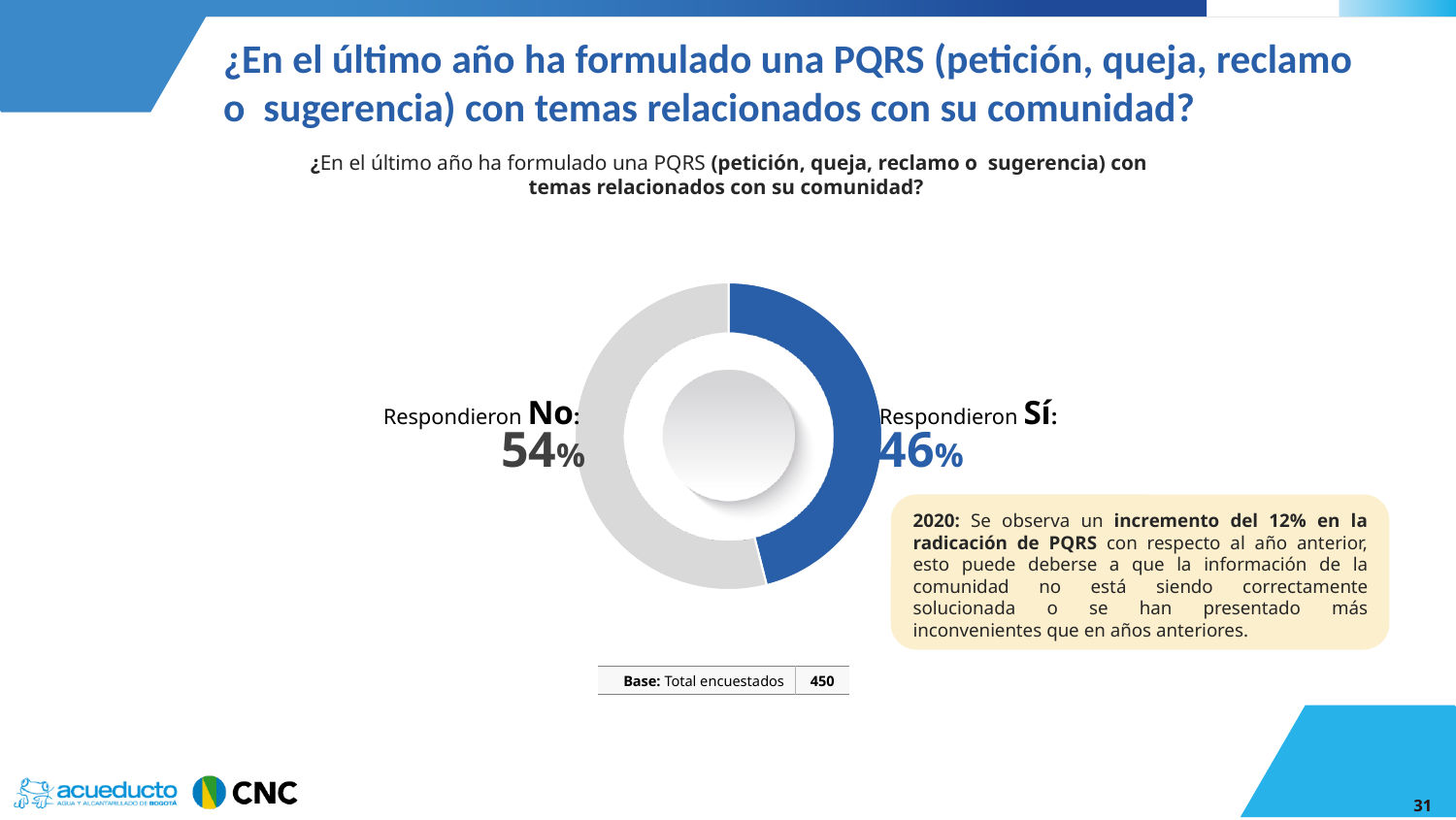
How many response categories are shown in the chart? 2 What percentage of respondents answered "No"? 54% What is the total number of respondents (base) shown below the chart? 450 Which colour represents the "Sí" responses in the chart? Blue What is the difference in percentage points between the "No" and "Sí" responses? 8 Which response has the smallest share in the chart? Sí What kind of chart is shown on the slide? Doughnut (pie) chart Which response has the larger share, "No" or "Sí"? No What percentage of respondents answered "Sí"? 46% Is the share of respondents who answered "Sí" greater or less than 50%? less